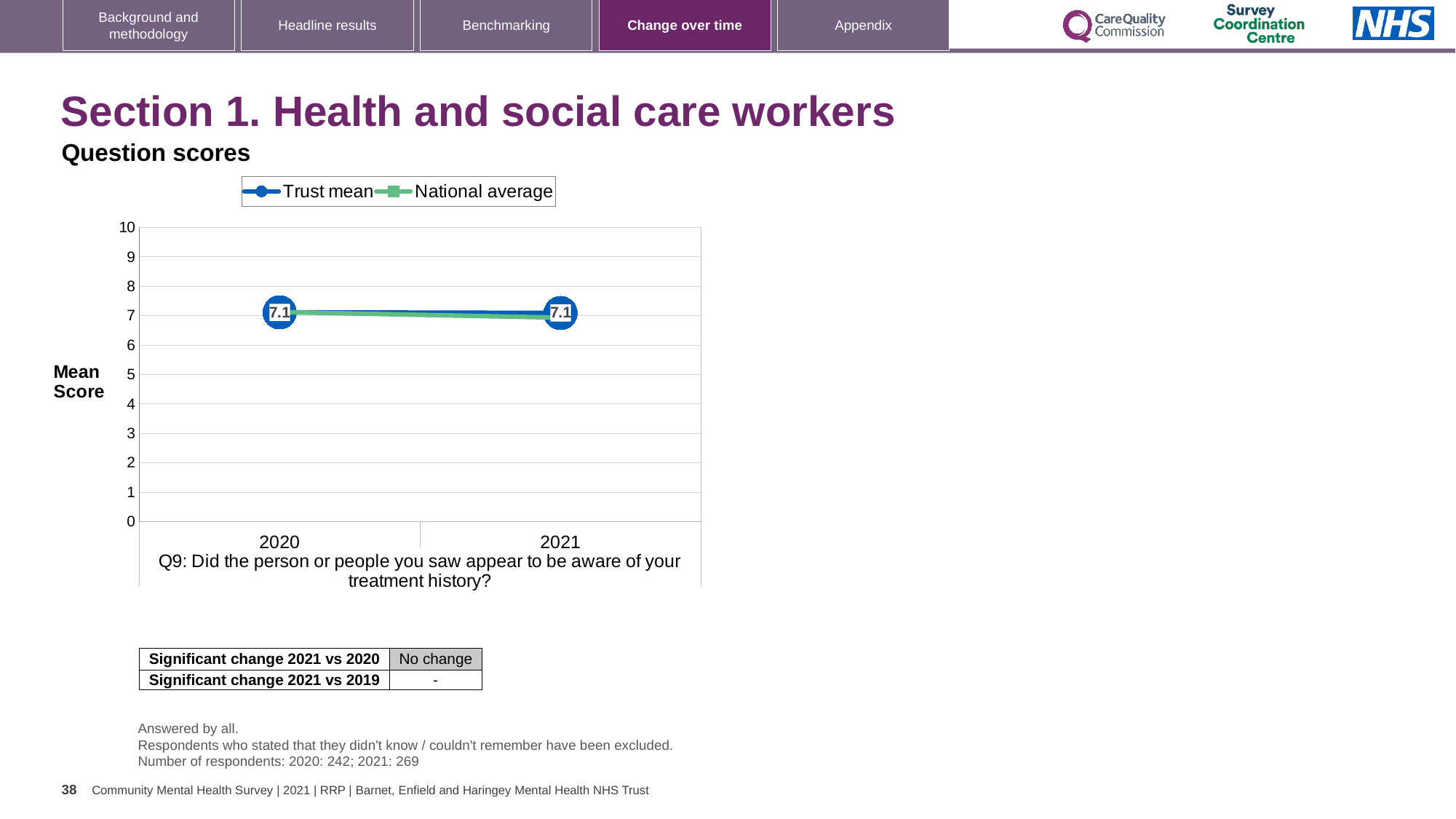
What is the Trust mean score for 2020? 7.1 How many years are plotted on the x axis of the chart? 2 Does the Trust mean rise, fall, or stay flat from 2020 to 2021? stays flat What is the label on the y axis of the chart? Mean Score Is the Trust mean score for 2021 higher, lower, or the same as for 2020? the same What is the difference between the Trust mean scores for 2021 and 2020? 0 What is the Trust mean score for 2021? 7.1 What kind of chart is shown on the slide? line chart How many series does the chart legend list? 2 Is the National average score for 2021 greater or less than 8? less Is the Trust mean score for 2020 greater or less than 5? greater What are the two series named in the chart legend? Trust mean and National average